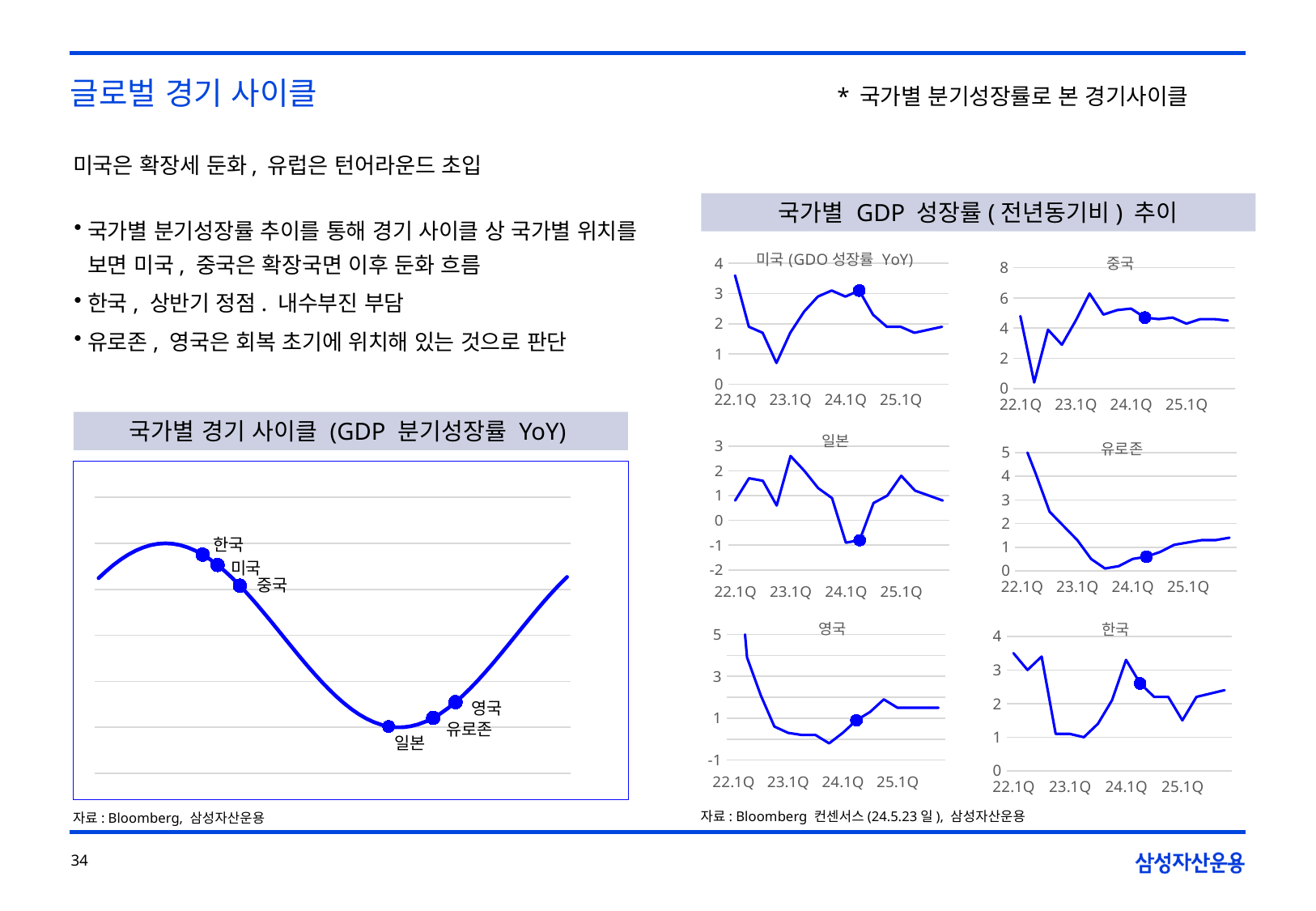
In the 일본 chart on the right, is the lowest value on the line greater or less than 0? less In the left chart 국가별 경기 사이클 (GDP 분기성장률 YoY), which country is marked higher on the curve, 영국 or 유로존? 영국 In the 영국 chart on the right, does the line rise or fall between 22.1Q and 23.1Q? fall In the 유로존 chart on the right, does the line rise or fall between 22.1Q and 23.1Q? fall What kind of chart is the left chart titled 국가별 경기 사이클 (GDP 분기성장률 YoY)? line chart How many small line charts are shown in the right panel titled 국가별 GDP 성장률 (전년동기비) 추이? 6 In the left chart 국가별 경기 사이클 (GDP 분기성장률 YoY), how many countries are marked on the cycle curve? 6 In the 미국 (GDO 성장률 YoY) chart on the right, is the value at 22.1Q greater or less than 3? greater In the left chart 국가별 경기 사이클 (GDP 분기성장률 YoY), which country is marked at the lowest point of the cycle curve? 일본 In the left chart 국가별 경기 사이클 (GDP 분기성장률 YoY), which country is marked closest to the peak of the cycle curve? 한국 In the 중국 chart on the right, is the highest value on the line greater or less than 6? greater What is the title of the right-hand panel of small charts? 국가별 GDP 성장률 (전년동기비) 추이